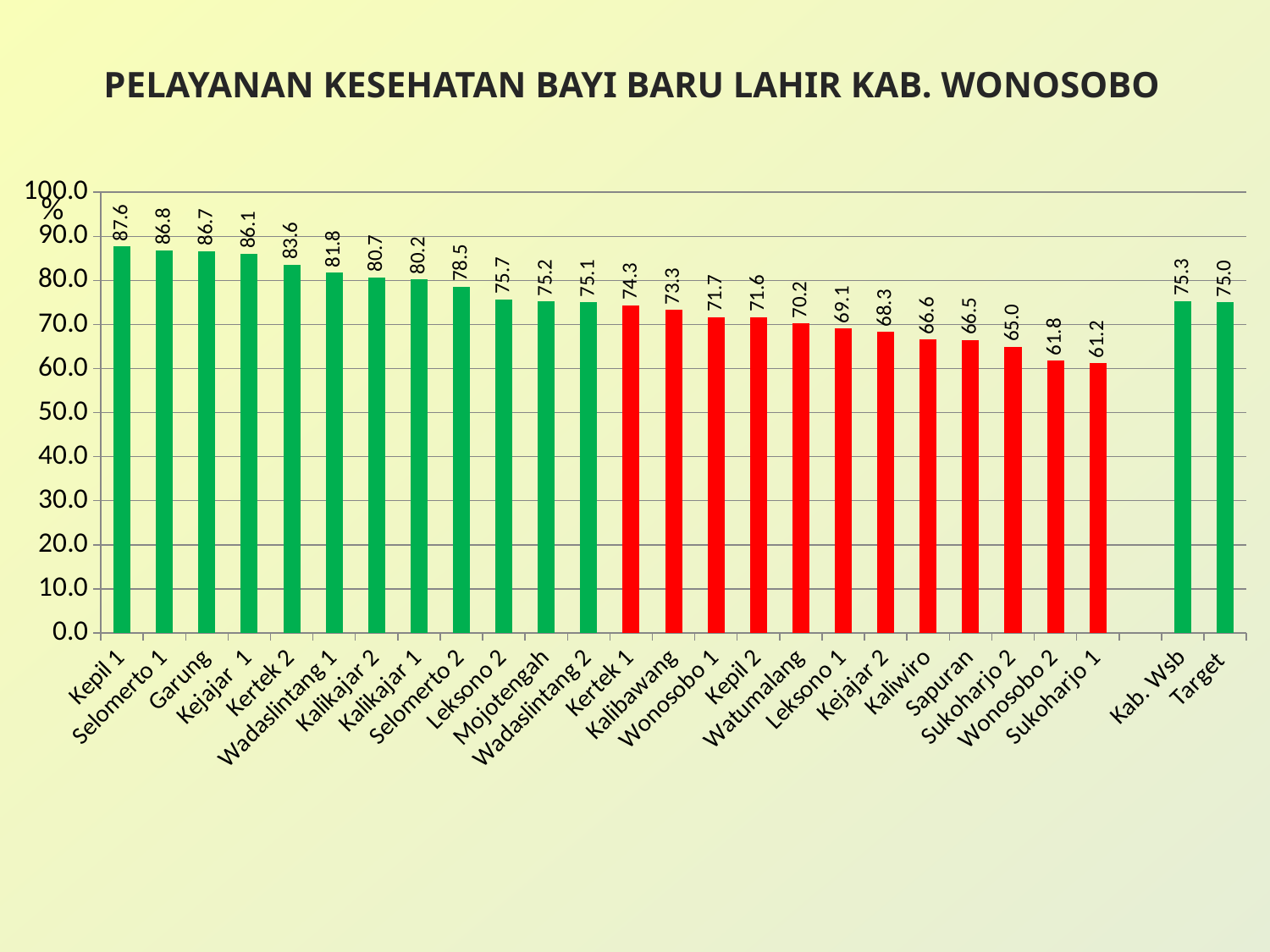
What is the value for Kepil 1? 87.6 Which category has the highest value? Kepil 1 Which is larger, the value for Kertek 2 or the value for Kalibawang? Kertek 2 How many bars are plotted in the chart? 26 What colour are the bars for Kertek 1 through Sukoharjo 1? Red What is the value for Watumalang? 70.2 What is the difference between the values for Kab. Wsb and Target? 0.3 Which category has the lowest value? Sukoharjo 1 What is the difference between the values for Kepil 1 and Sukoharjo 1? 26.4 What is the value for Target? 75.0 What is the value for Kab. Wsb? 75.3 What kind of chart is shown on the slide? Bar chart